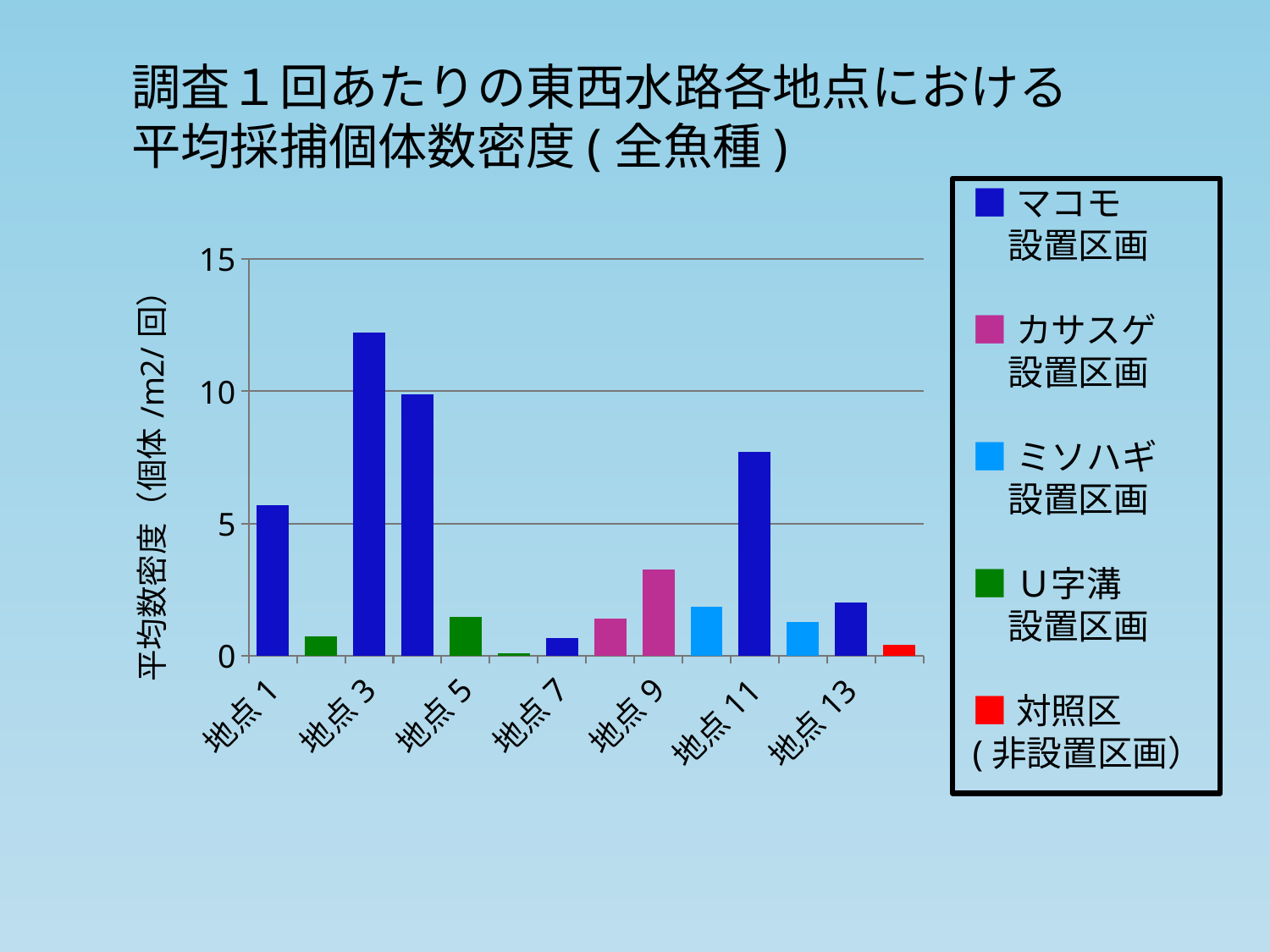
Is the value for 地点11 greater or less than 10? less Which is larger, the value for 地点1 or the value for 地点9? 地点1 How many entries does the legend list? 5 What colour represents 対照区 (非設置区画) in the legend? red Is the value for 地点1 greater or less than 5? greater How many bars are plotted in the chart? 14 Which labelled site has the highest average density? 地点3 Is the value for 地点3 greater or less than 10? greater Which is larger, the value for 地点3 or the value for 地点11? 地点3 What kind of chart is shown on the slide? bar chart